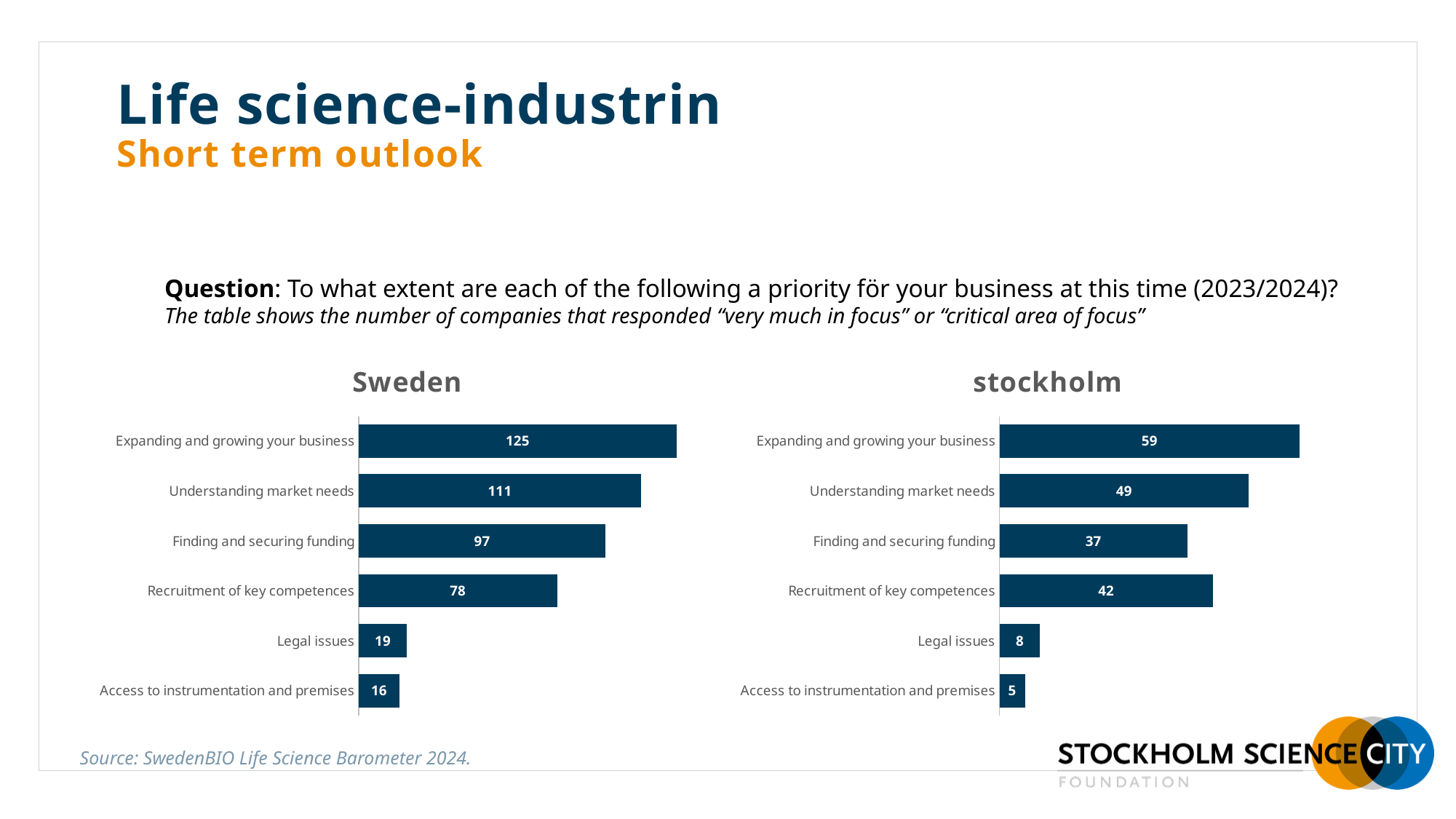
In the stockholm chart, which category has the highest value? Expanding and growing your business What is the title of the chart on the left side of the slide? Sweden In the Sweden chart, what is the difference between Understanding market needs and Finding and securing funding? 14 In the stockholm chart, what is the value for Recruitment of key competences? 42 In the Sweden chart, which category has the lowest value? Access to instrumentation and premises In the stockholm chart, which is larger: Finding and securing funding or Recruitment of key competences? Recruitment of key competences In the stockholm chart, what is the difference between Expanding and growing your business and Access to instrumentation and premises? 54 In the Sweden chart, what is the value for Expanding and growing your business? 125 What kind of chart is the stockholm chart? Bar chart In the stockholm chart, what is the value for Legal issues? 8 In the Sweden chart, what is the value for Legal issues? 19 How many categories does the Sweden chart show? 6